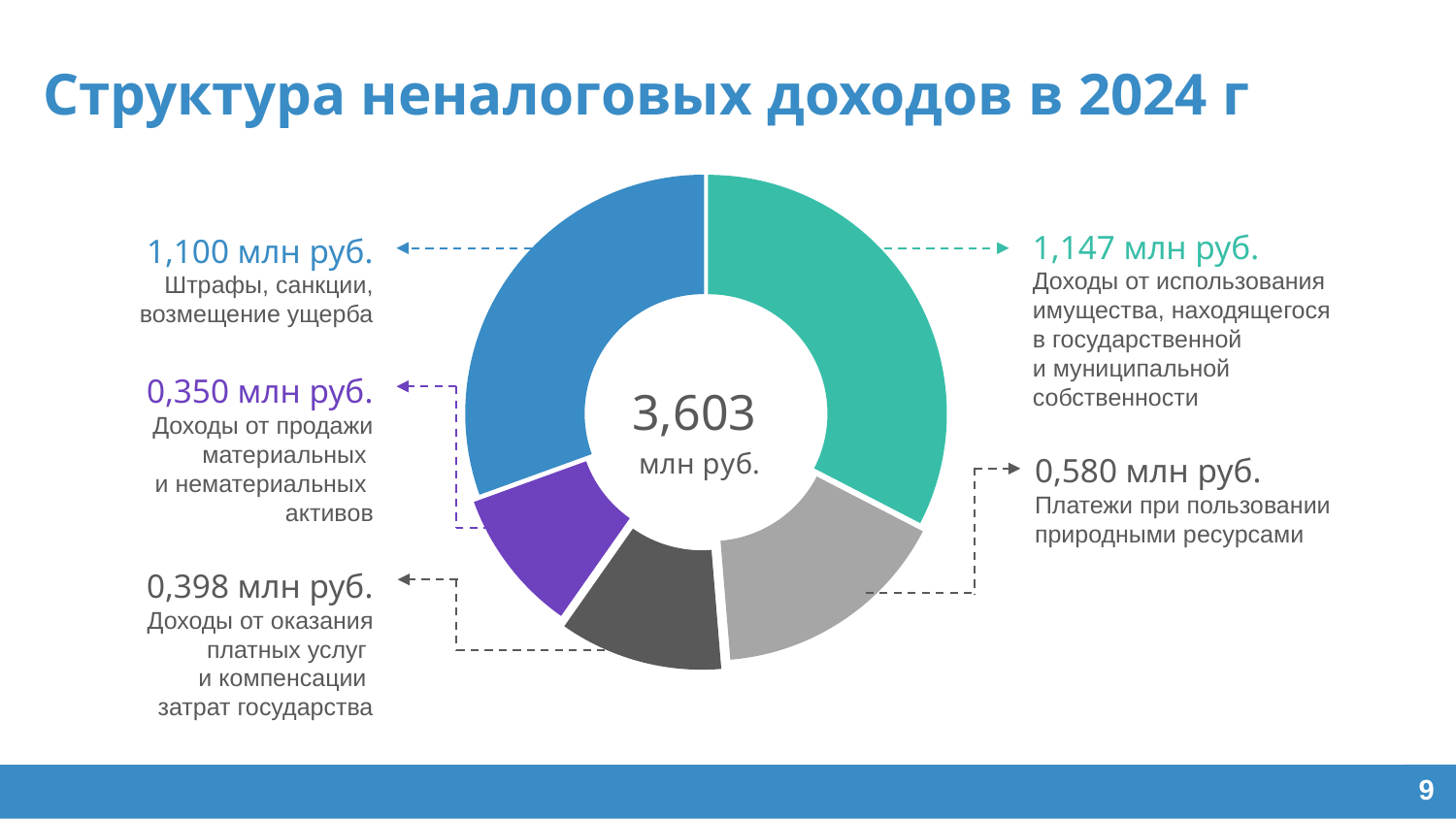
What kind of chart is shown on the slide? Donut (pie) chart Which category has the largest value? Доходы от использования имущества, находящегося в государственной и муниципальной собственности What is the value for 'Штрафы, санкции, возмещение ущерба'? 1,100 млн руб. What is the title of the slide? Структура неналоговых доходов в 2024 г Which is larger: 'Штрафы, санкции, возмещение ущерба' or 'Платежи при пользовании природными ресурсами'? Штрафы, санкции, возмещение ущерба What is the value for 'Платежи при пользовании природными ресурсами'? 0,580 млн руб. Which category has the smallest value? Доходы от продажи материальных и нематериальных активов What is the value for 'Доходы от использования имущества, находящегося в государственной и муниципальной собственности'? 1,147 млн руб. What total value is printed in the centre of the donut chart? 3,603 млн руб. How many segments does the donut chart have? 5 What is the difference between 'Платежи при пользовании природными ресурсами' and 'Доходы от оказания платных услуг и компенсации затрат государства'? 0,182 млн руб. What is the value for 'Доходы от продажи материальных и нематериальных активов'? 0,350 млн руб.